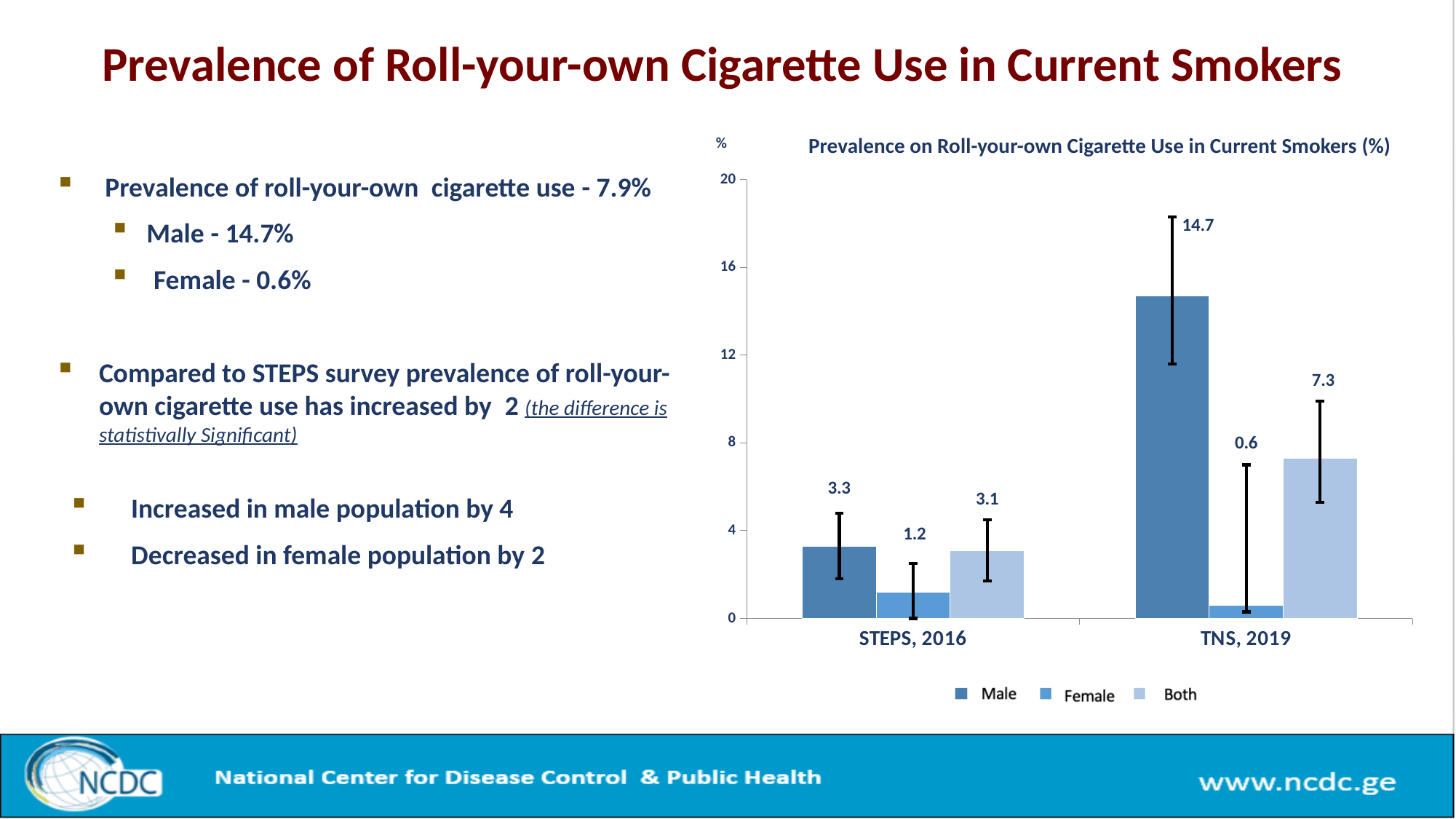
How many categories are shown on the x axis? 2 How many series does the legend list? 3 What is the Male value for TNS, 2019? 14.7 Which is larger, the Female value for STEPS, 2016 or the Female value for TNS, 2019? STEPS, 2016 Which series has the highest value for TNS, 2019? Male What is the difference between the Male values for TNS, 2019 and STEPS, 2016? 11.4 What kind of chart is shown? bar chart Which series has the lowest value for STEPS, 2016? Female What is the Female value for STEPS, 2016? 1.2 What is the Both value for TNS, 2019? 7.3 Does the Both value rise or fall from STEPS, 2016 to TNS, 2019? rise What is the Male value for STEPS, 2016? 3.3